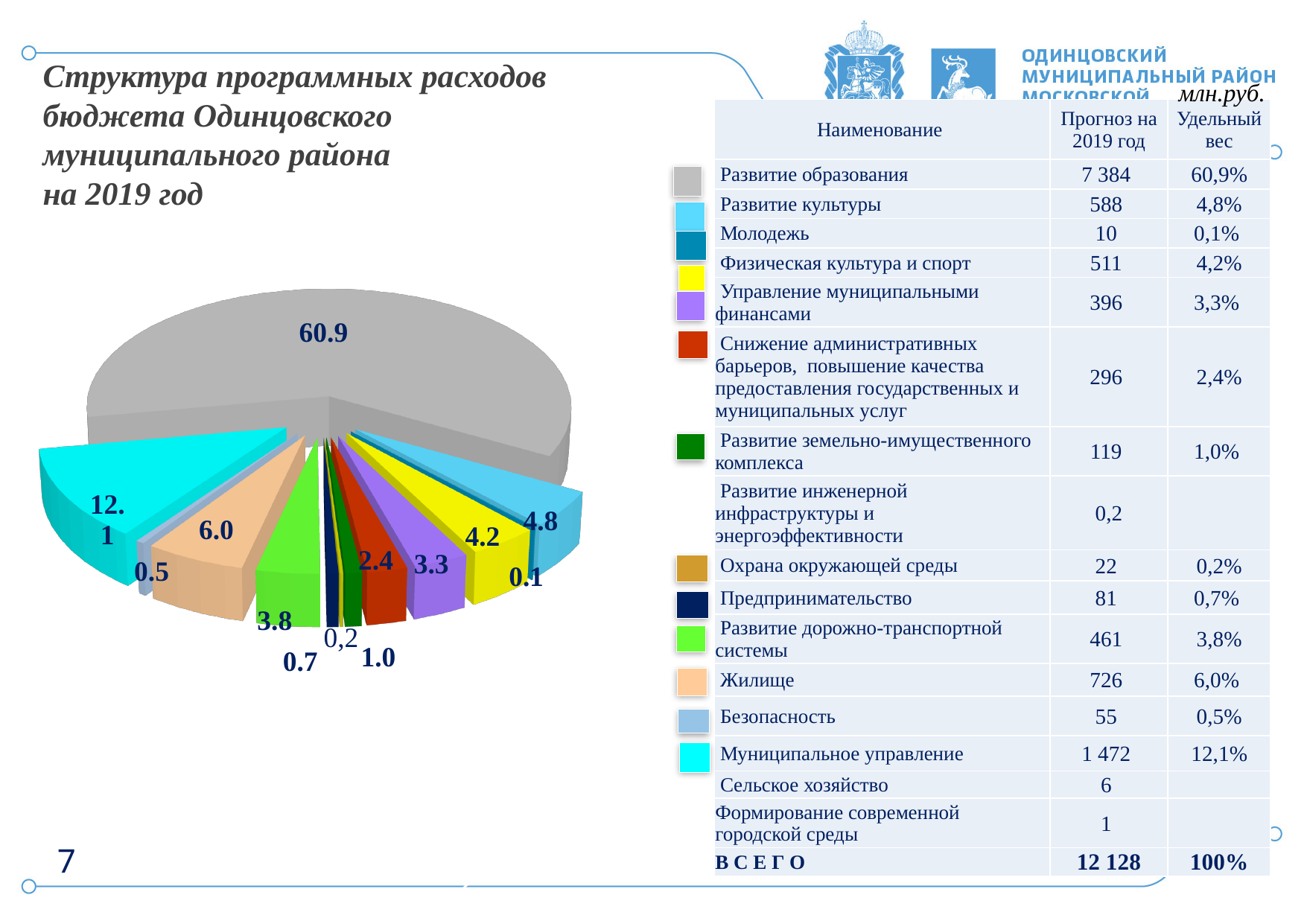
How many labeled slices does the pie chart have? 13 What colour is the slice representing Развитие образования in the pie chart? grey What kind of chart is shown on the slide? pie chart What is the data label on the largest slice of the pie chart? 60.9 What is the data label on the cyan slice (Муниципальное управление) in the pie chart? 12.1 What is the difference between the largest slice label (60.9) and the cyan slice label (12.1) in the pie chart? 48.8 What is the data label on the peach slice (Жилище) in the pie chart? 6.0 Which category has the largest slice in the pie chart? Развитие образования What is the data label on the red slice (Снижение административных барьеров) in the pie chart? 2.4 Which slice is larger in the pie chart: the peach slice (Жилище) or the light blue slice (Развитие культуры)? Жилище What is the data label on the yellow slice (Физическая культура и спорт) in the pie chart? 4.2 What is the smallest data label shown on the pie chart? 0.1